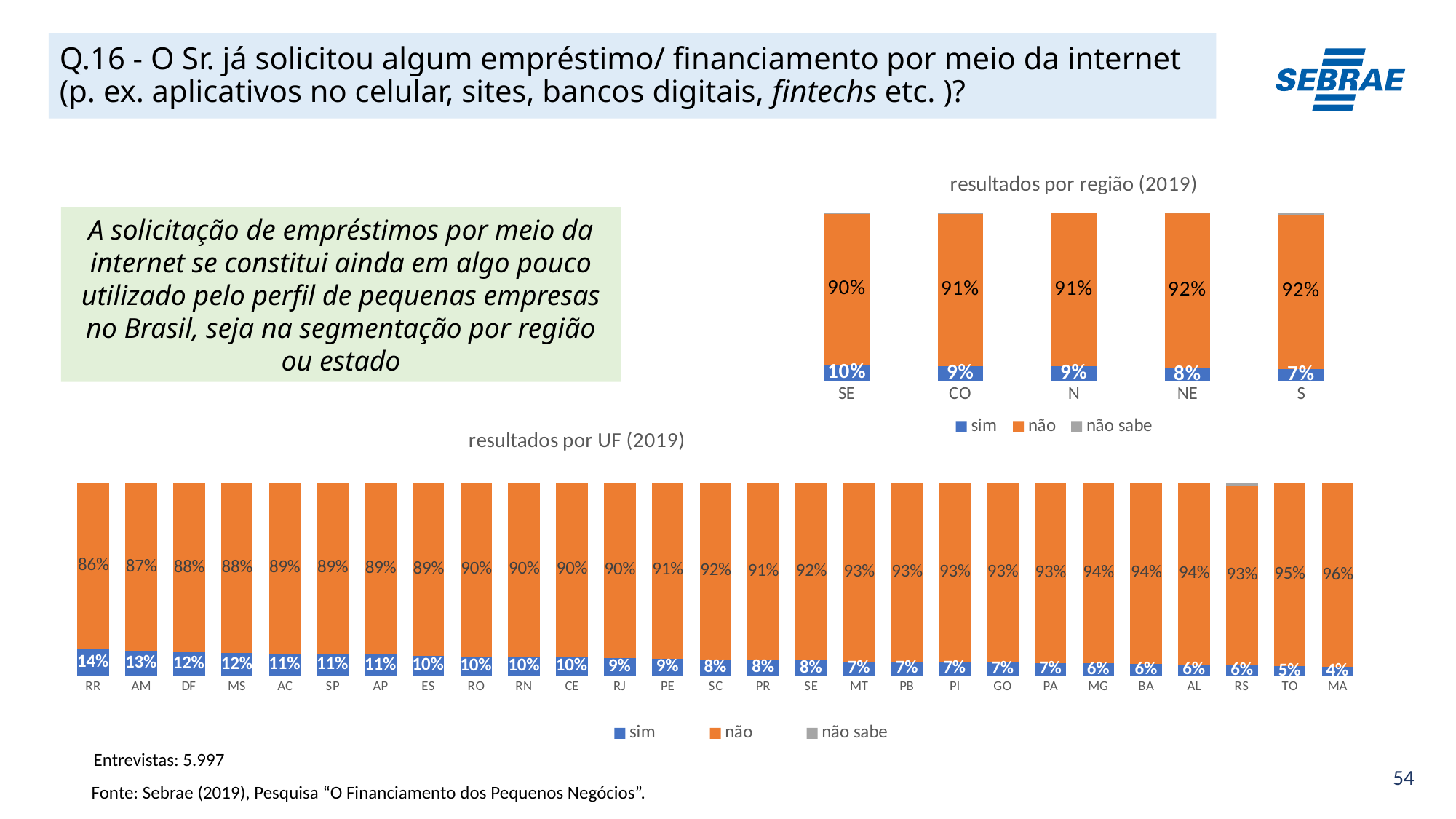
In the 'resultados por região (2019)' chart, what is the 'sim' value for SE? 10% In the 'resultados por UF (2019)' chart, which UF has the lowest 'sim' value? MA What kind of chart is the 'resultados por UF (2019)' chart? Stacked bar chart In the 'resultados por UF (2019)' chart, what is the 'sim' value for RR? 14% In the 'resultados por região (2019)' chart, how many series does the legend list? 3 In the 'resultados por região (2019)' chart, which region has the lowest 'sim' value? S In the 'resultados por UF (2019)' chart, how many UFs are shown on the x axis? 27 In the 'resultados por região (2019)' chart, how many regions are shown on the x axis? 5 In the 'resultados por região (2019)' chart, what is the 'não' value for NE? 92% In the 'resultados por UF (2019)' chart, what is the 'não' value for MA? 96% In the 'resultados por UF (2019)' chart, which UF has the highest 'sim' value? RR In the 'resultados por UF (2019)' chart, what is the difference between the 'sim' values for RR and MA? 10%